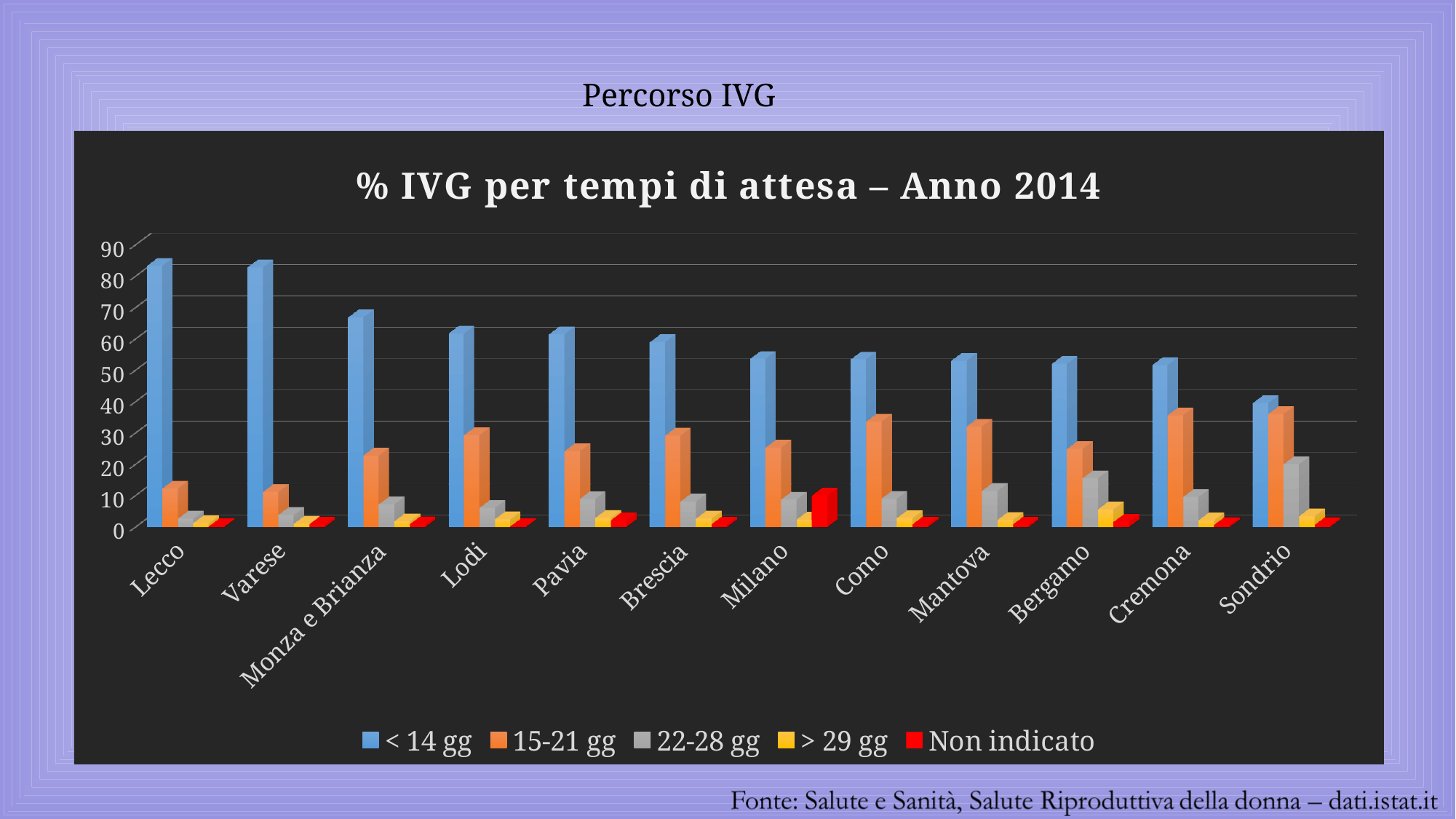
Do the '< 14 gg' values rise or fall moving from Lecco to Sondrio along the x axis? fall Which province has the highest value for the 'Non indicato' series? Milano Is the '15-21 gg' value for Como greater or less than 30? greater How many provinces are shown on the x axis? 12 Is the '< 14 gg' value for Lecco greater or less than 80? greater Is the '< 14 gg' value for Sondrio greater or less than 50? less Which province has the highest value for the '22-28 gg' series? Sondrio How many series does the legend list? 5 What is the title of the chart? % IVG per tempi di attesa – Anno 2014 What kind of chart is shown on the slide? bar chart Which province has the lowest value for the '< 14 gg' series? Sondrio